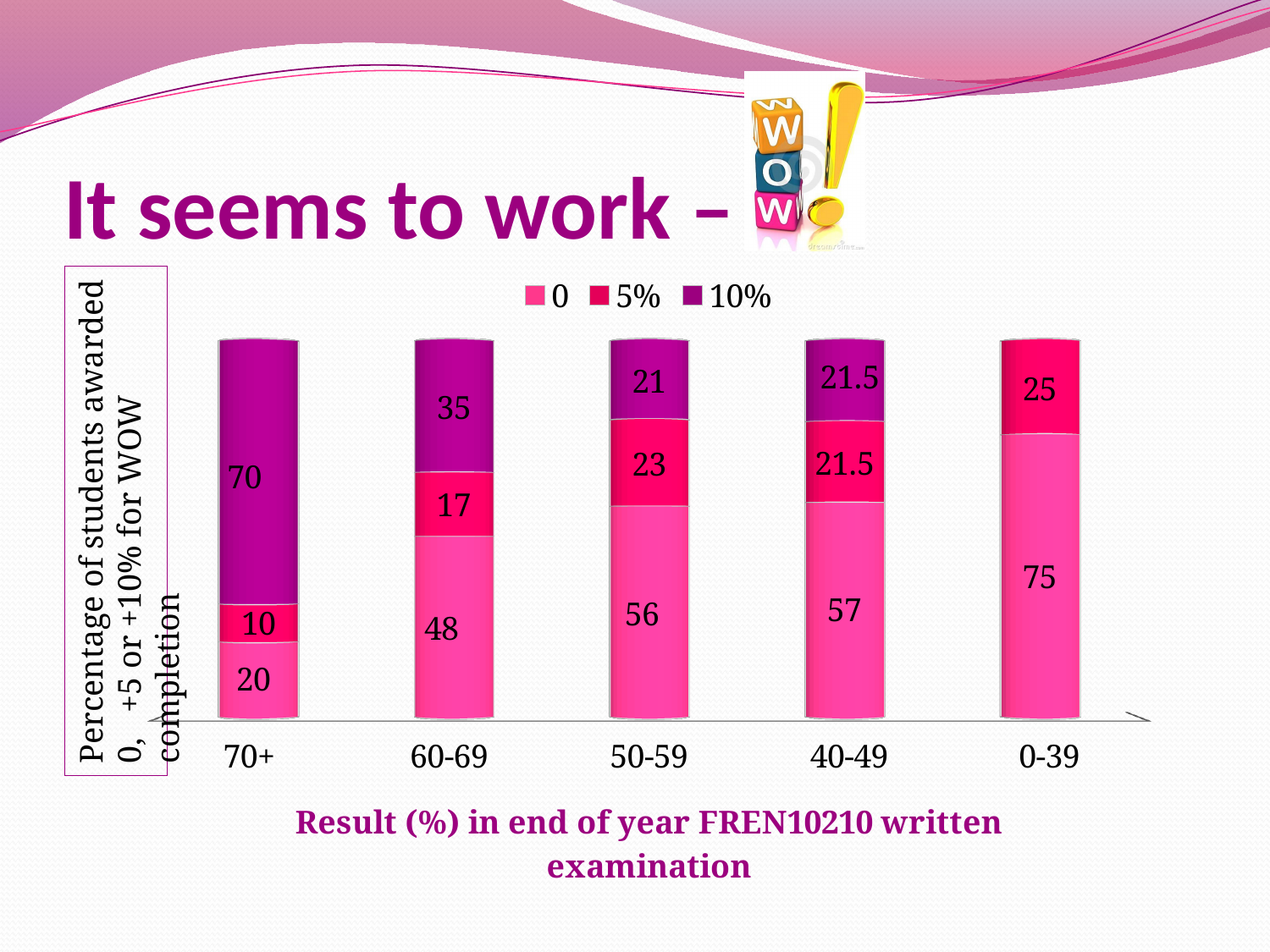
What is the difference between the 10% series values for 70+ and 60-69? 35 How many result categories are shown on the x axis? 5 Which category has the highest value for the 0 series? 0-39 What is the value of the 0 series for the 60-69 category? 48 What is the value of the 10% series for the 70+ category? 70 Which category has the lowest value for the 0 series? 70+ What kind of chart is shown on the slide? stacked bar chart Which is larger: the 0 series value for 50-59 or for 40-49? 40-49 What is the value of the 5% series for the 50-59 category? 23 What is the x-axis title of the chart? Result (%) in end of year FREN10210 written examination How many series does the legend list? 3 What is the value of the 5% series for the 0-39 category? 25